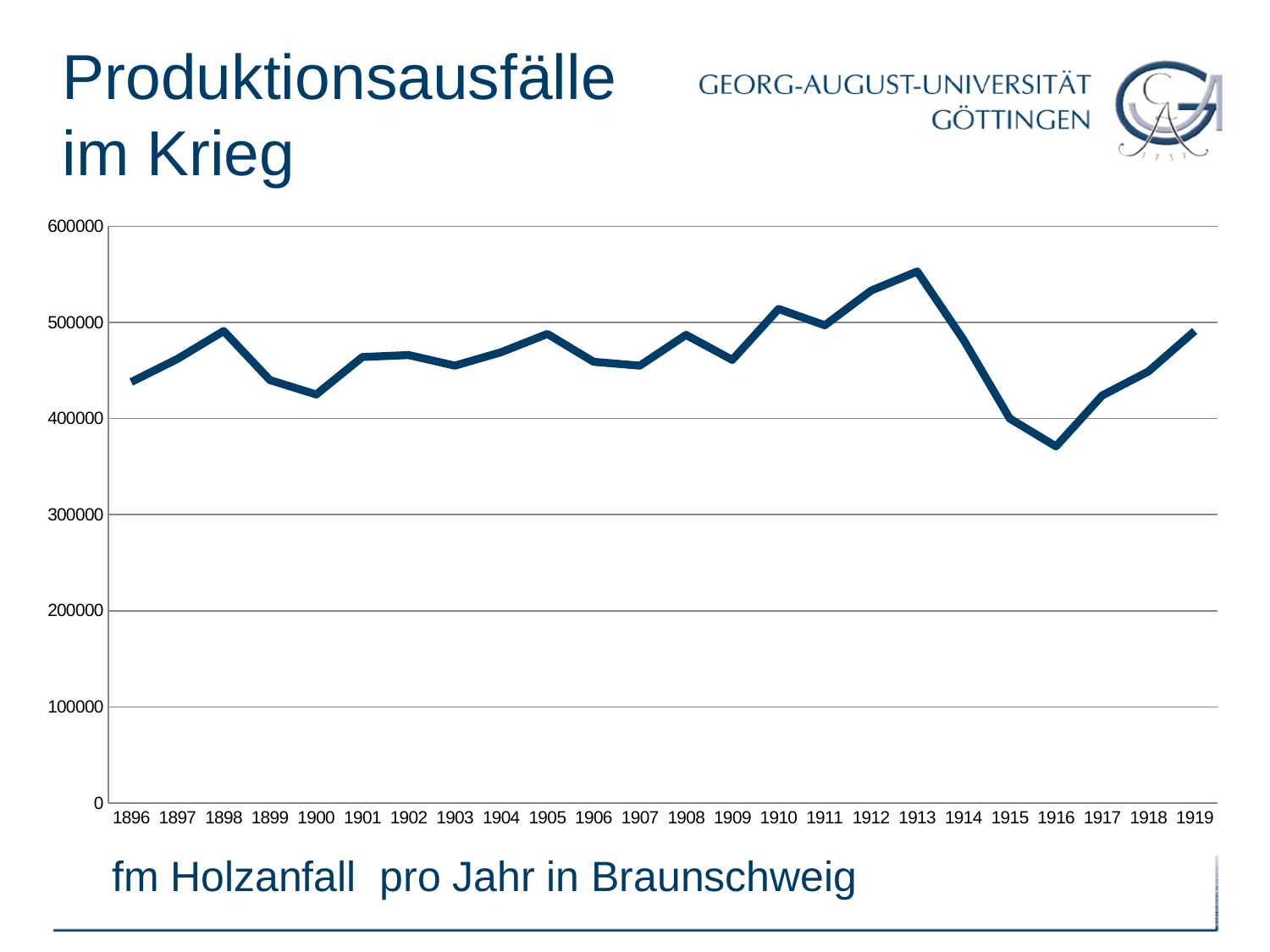
Is the value for 1916 greater or less than 400000? less Which year has the larger value, 1898 or 1900? 1898 Is the value for 1900 greater or less than 400000? greater Which year has the larger value, 1916 or 1919? 1919 How many years are plotted along the x axis of the chart? 24 Is the value for 1913 greater or less than 500000? greater In which year does the chart reach its lowest value? 1916 What does the caption below the chart say is being measured? fm Holzanfall pro Jahr in Braunschweig Do the values rise or fall from 1913 to 1916? fall In which year does the chart reach its highest value? 1913 What kind of chart is shown on the slide? line chart